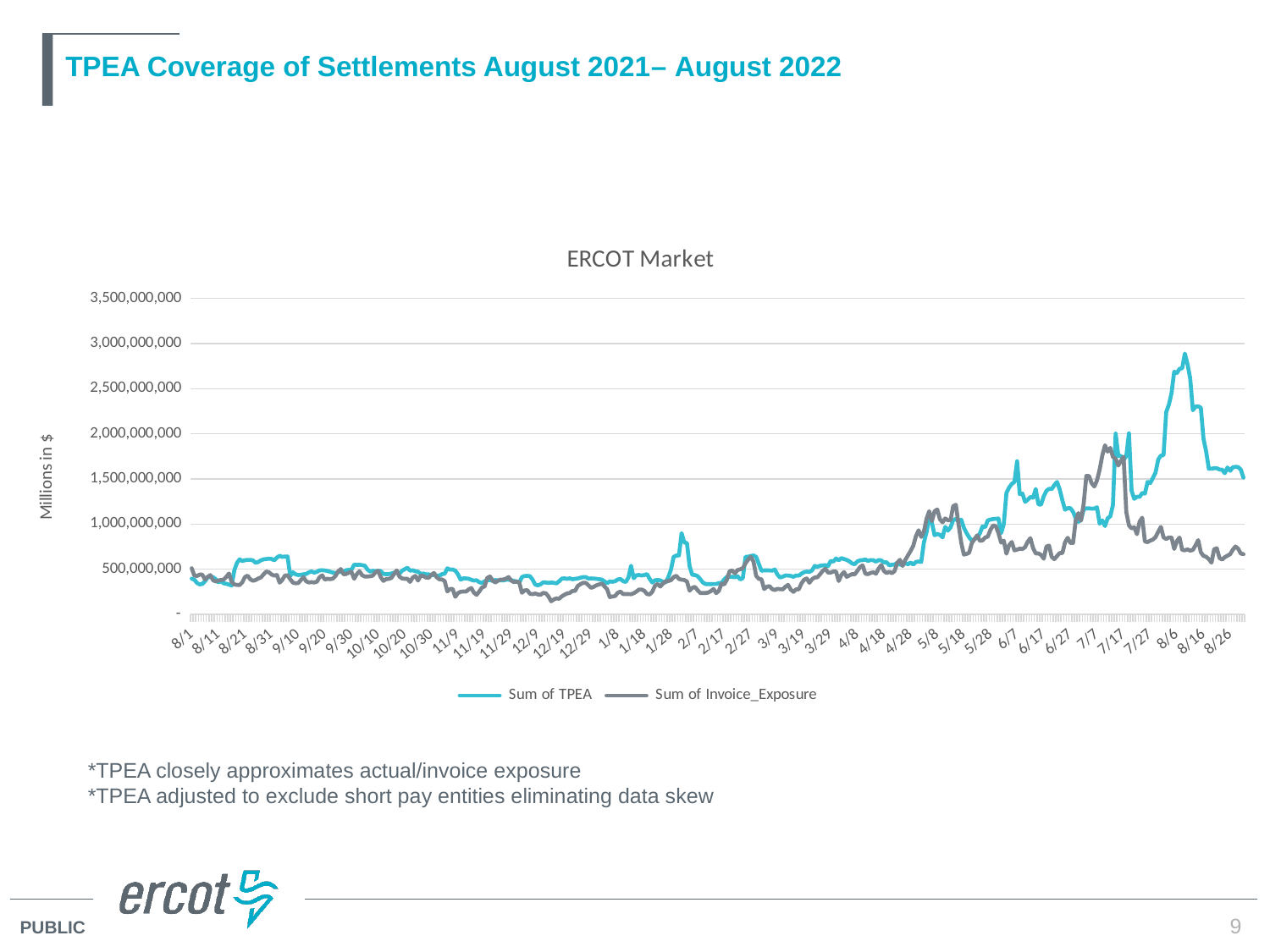
What is the title of the chart? ERCOT Market How many series does the legend of the chart list? 2 Is the peak value of Sum of TPEA around 8/6 greater or less than 2,500,000,000? greater What is the label on the vertical axis of the chart? Millions in $ Overall, does Sum of TPEA rise or fall from 8/1 to 8/26 along the x axis? rise Is the value of Sum of TPEA at 12/9 greater or less than 500,000,000? less Is the peak value of Sum of Invoice_Exposure around 7/7 greater or less than 1,500,000,000? greater What kind of chart is shown on the slide? line chart Which series reaches the highest value on the chart? Sum of TPEA Around 8/6, which series is higher, Sum of TPEA or Sum of Invoice_Exposure? Sum of TPEA